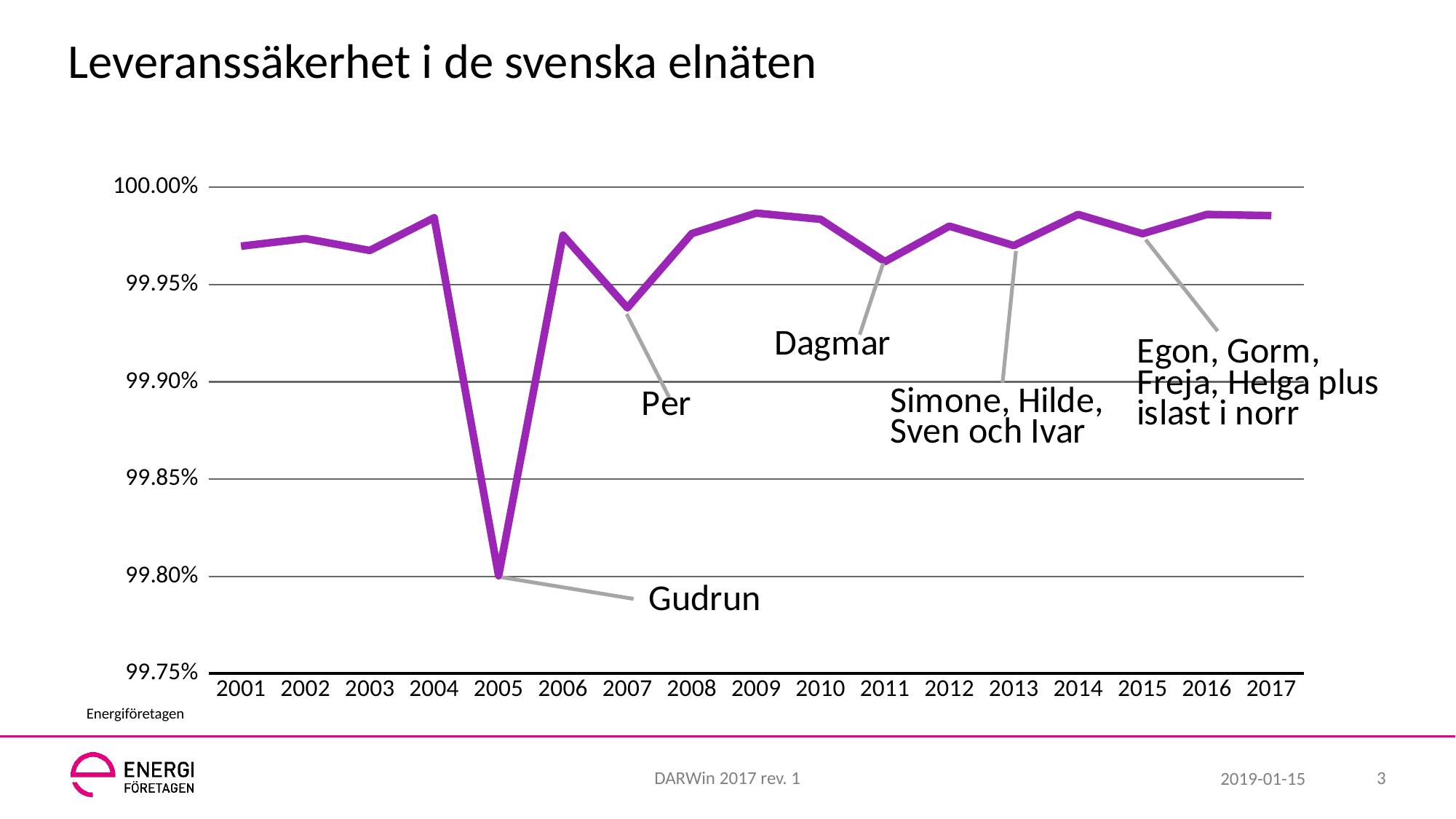
Does the line rise or fall from 2005 to 2006? rise Is the value for 2009 greater or less than 99.95%? greater Is the value for 2007 greater or less than 99.95%? less Is the value for 2005 greater or less than 99.85%? less Which storm name is annotated at the 2005 low point? Gudrun Which year has the lowest value on the chart? 2005 Which year has the larger value, 2007 or 2008? 2008 What is the title of the slide? Leveranssäkerhet i de svenska elnäten How many years are plotted along the x axis? 17 What kind of chart is shown on the slide? line chart Which year has the larger value, 2005 or 2006? 2006